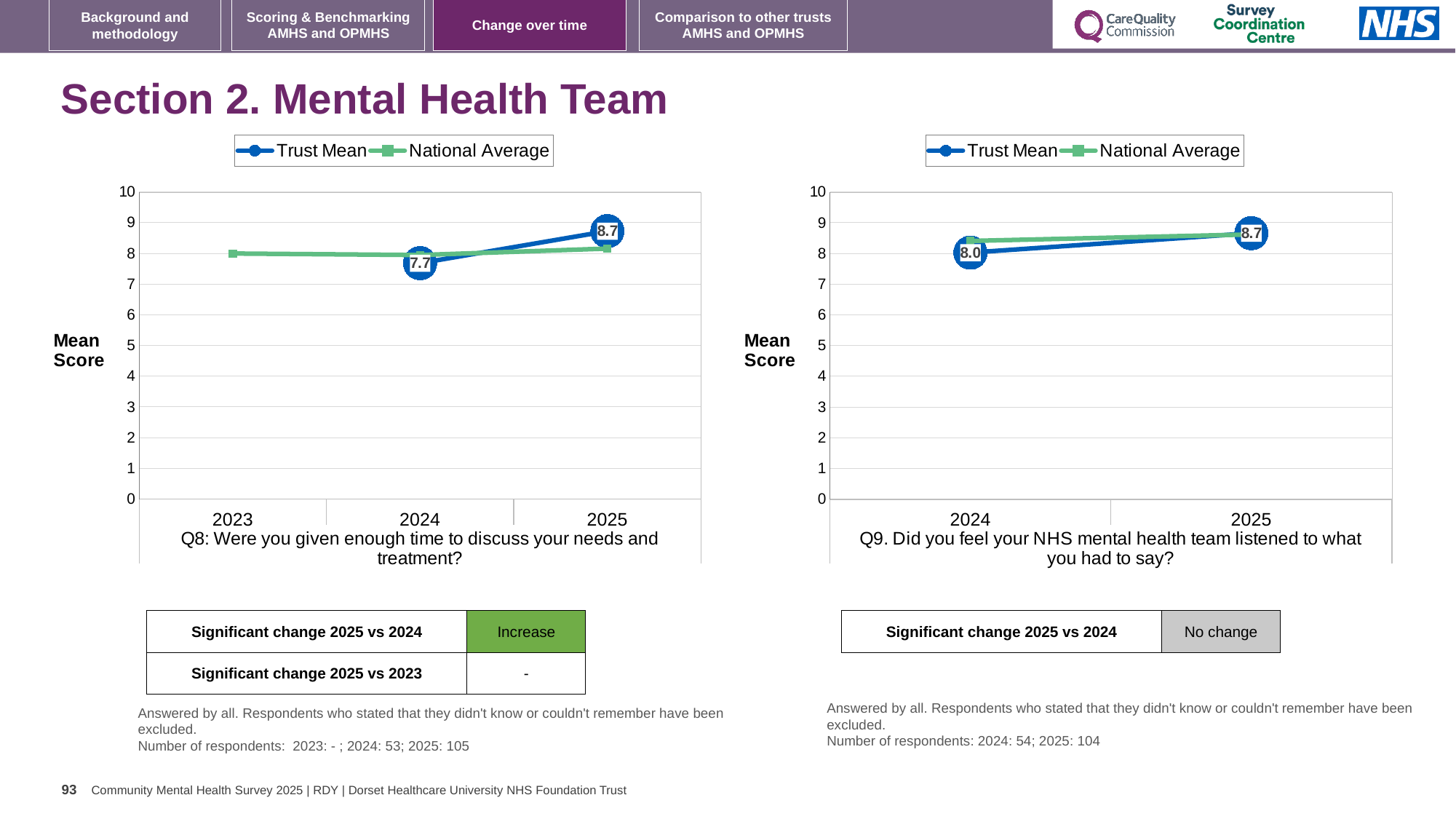
In the Q9 chart on the right, what is the Trust Mean for 2025? 8.7 What type of chart is the Q8 chart on the left? Line chart In the Q8 chart on the left, by how much did the Trust Mean change from 2024 to 2025? 1.0 How many series does the legend of the Q9 chart on the right list? 2 In the Q8 chart on the left, what is the Trust Mean for 2024? 7.7 In the Q9 chart on the right, what is the difference between the Trust Mean in 2025 and in 2024? 0.7 In the Q8 chart on the left, is the National Average for 2023 greater or less than 5? greater In the Q8 chart on the left, what is the Trust Mean for 2025? 8.7 In the Q9 chart on the right, what is the Trust Mean for 2024? 8.0 In the Q8 chart on the left, which is higher in 2025, the Trust Mean or the National Average? Trust Mean How many years are shown on the x axis of the Q8 chart on the left? 3 In the Q9 chart on the right, does the Trust Mean rise or fall from 2024 to 2025? Rise